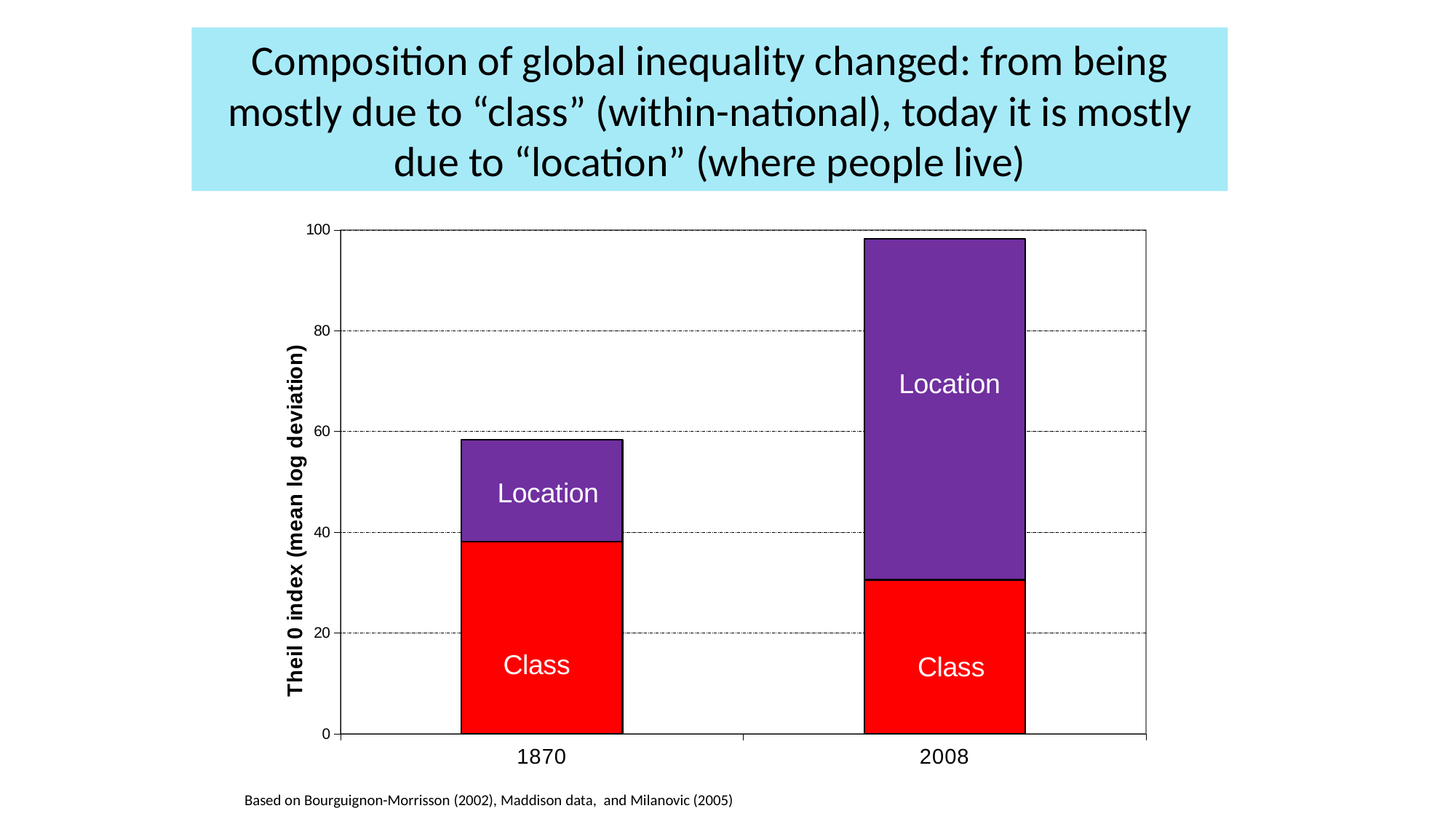
Is the Class component larger in 1870 or in 2008? 1870 Is the Class component for 2008 greater or less than 40? less How many years (categories) are shown on the x axis? 2 What is the title of the y axis? Theil 0 index (mean log deviation) In 1870, which component is larger, Class or Location? Class What kind of chart is shown on the slide? stacked bar chart How many components (series) make up each stacked bar? 2 Is the total value of the 2008 bar greater or less than 80? greater Is the Location component larger in 1870 or in 2008? 2008 Does the total Theil 0 index rise or fall from 1870 to 2008? rise